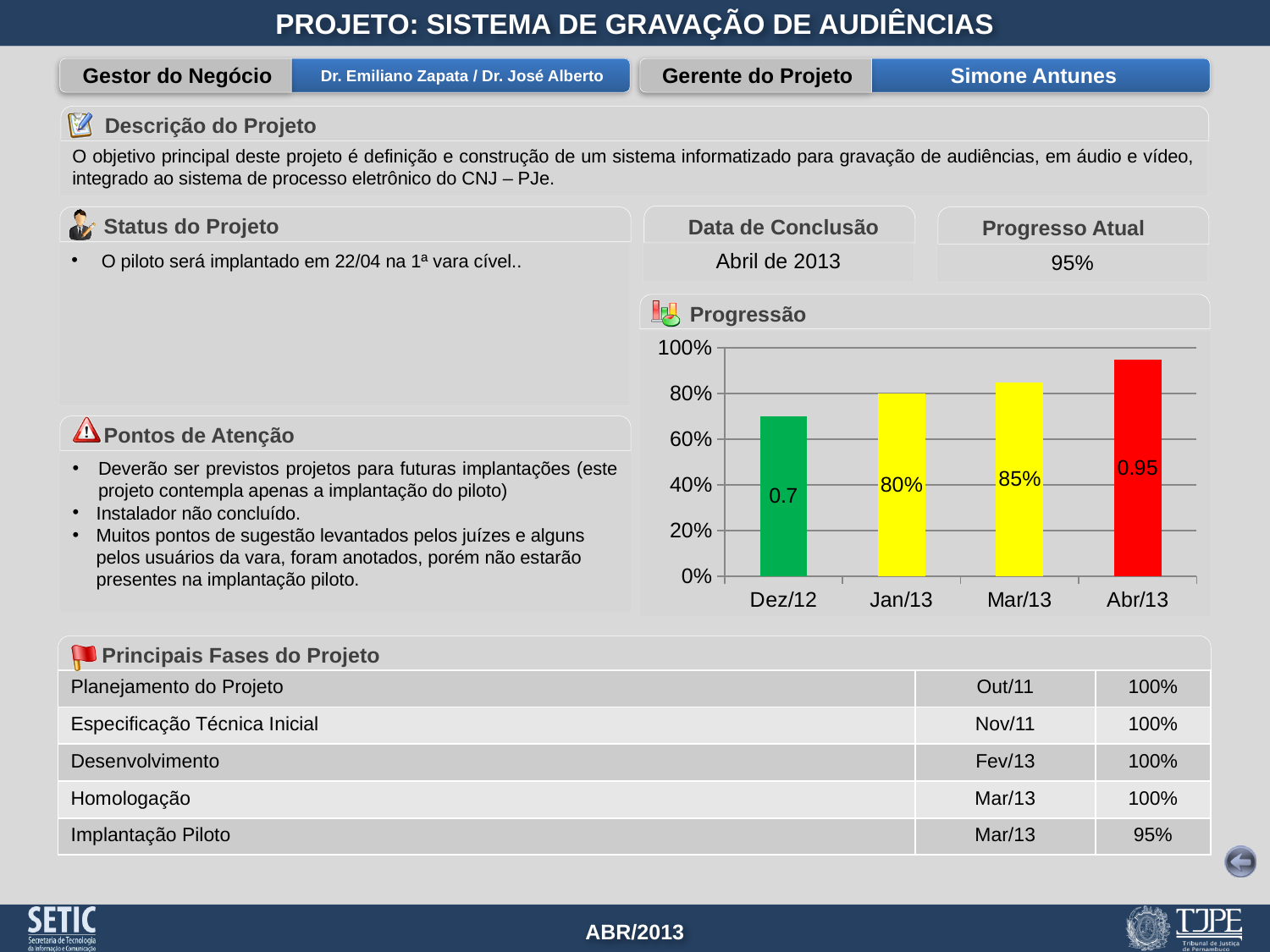
What is the data label on the Abr/13 bar in the Progressão chart? 0.95 Do the values in the Progressão chart rise or fall from Dez/12 to Abr/13? rise Which month has the highest bar in the Progressão chart? Abr/13 What is the data label on the Dez/12 bar in the Progressão chart? 0.7 In the Progressão chart, which is larger: the value for Jan/13 or the value for Mar/13? Mar/13 How many months are plotted in the Progressão chart? 4 Which month has the lowest bar in the Progressão chart? Dez/12 What value is shown for Mar/13 in the Progressão chart? 85% Is the value for Dez/12 in the Progressão chart greater or less than 60%? greater In the Progressão chart, what is the difference between the Mar/13 and Jan/13 values? 5% What kind of chart is the Progressão chart? bar chart What value is shown for Jan/13 in the Progressão chart? 80%